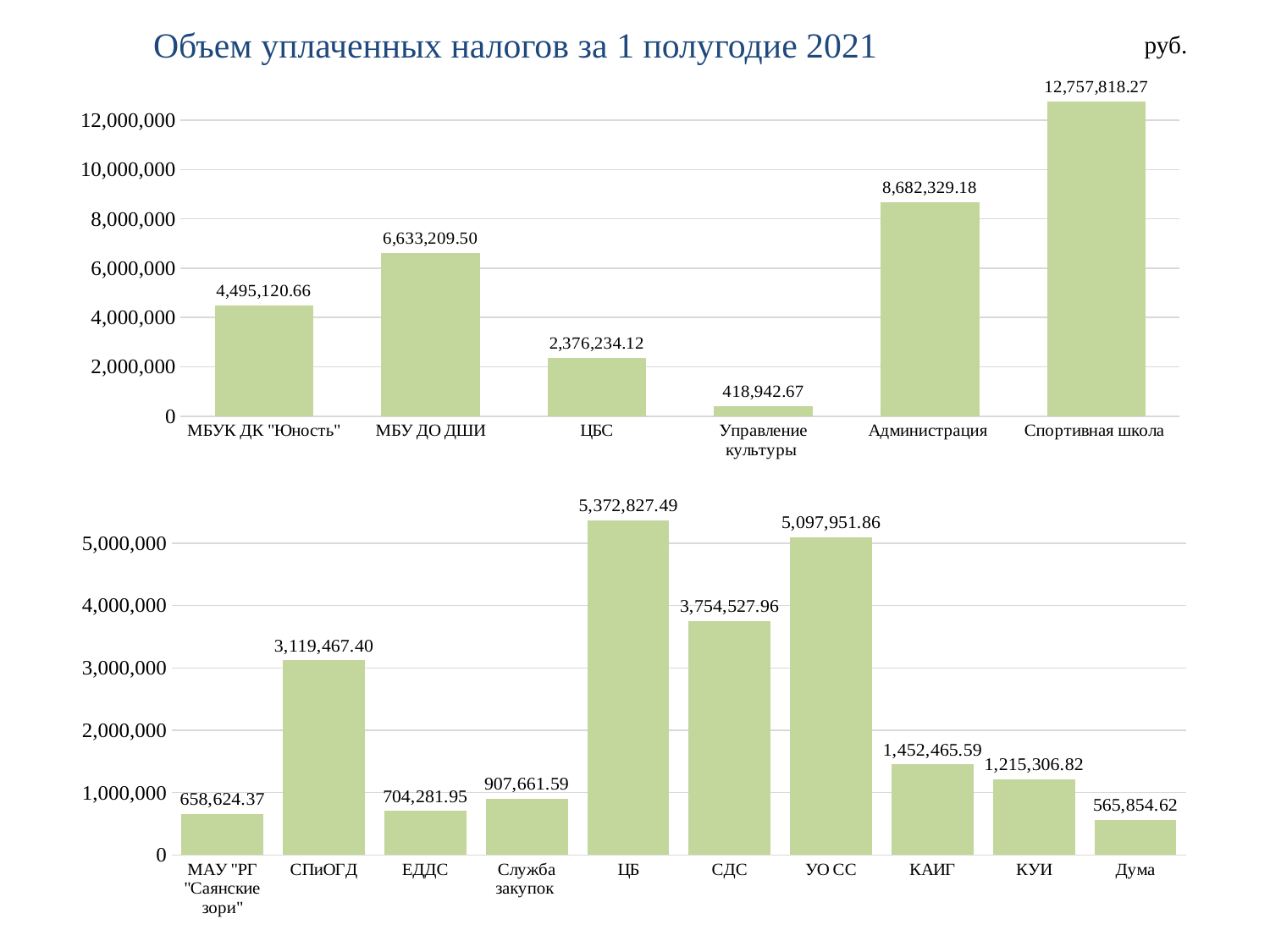
In the bottom chart, what is the value for СДС? 3,754,527.96 In the bottom chart, which category has the lowest value? Дума What type of chart is the top chart? Bar chart In the bottom chart, which category has the highest value? ЦБ In the top chart, what is the difference between Спортивная школа and Администрация? 4,075,489.09 In the top chart, what is the value for Управление культуры? 418,942.67 In the bottom chart, how many categories are shown? 10 In the top chart, which category has the lowest value? Управление культуры In the top chart, how many categories are shown? 6 In the top chart, what is the value for Спортивная школа? 12,757,818.27 In the bottom chart, which is larger: СПиОГД or КАИГ? СПиОГД In the bottom chart, what is the difference between ЦБ and УО СС? 274,875.63